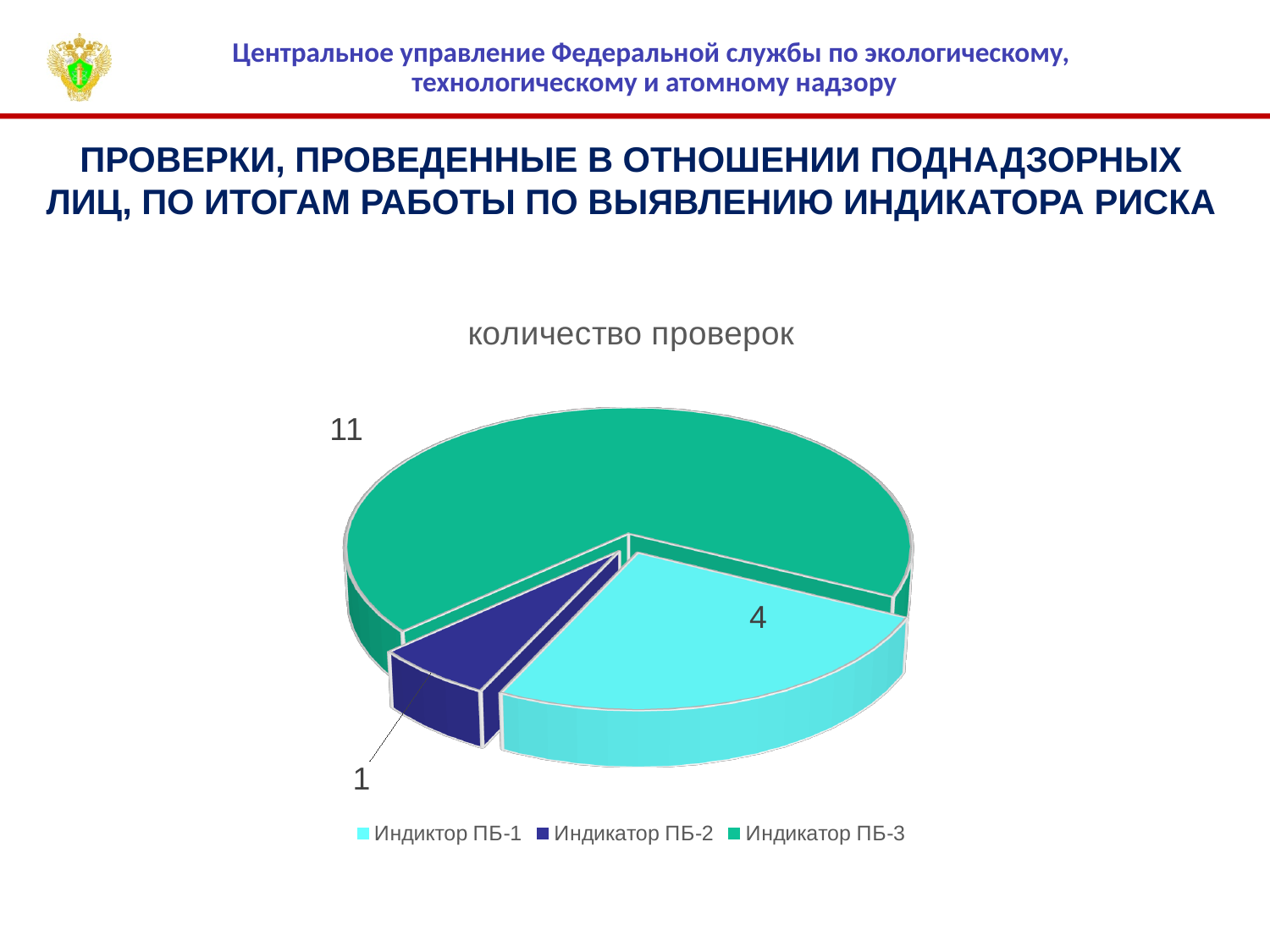
What is the value for Индикатор ПБ-2? 1 What is the value for Индикатор ПБ-3? 11 How many slices does the pie chart have? 3 Which category has the smallest slice? Индикатор ПБ-2 What is the chart's title? количество проверок Which is larger, the value for Индиктор ПБ-1 or the value for Индикатор ПБ-2? Индиктор ПБ-1 What share of the pie does Индиктор ПБ-1 represent? 25% Which category has the largest slice? Индикатор ПБ-3 How many entries does the legend list? 3 What type of chart is shown on the slide? pie chart What is the value for Индиктор ПБ-1? 4 What is the difference between the values for Индикатор ПБ-3 and Индиктор ПБ-1? 7